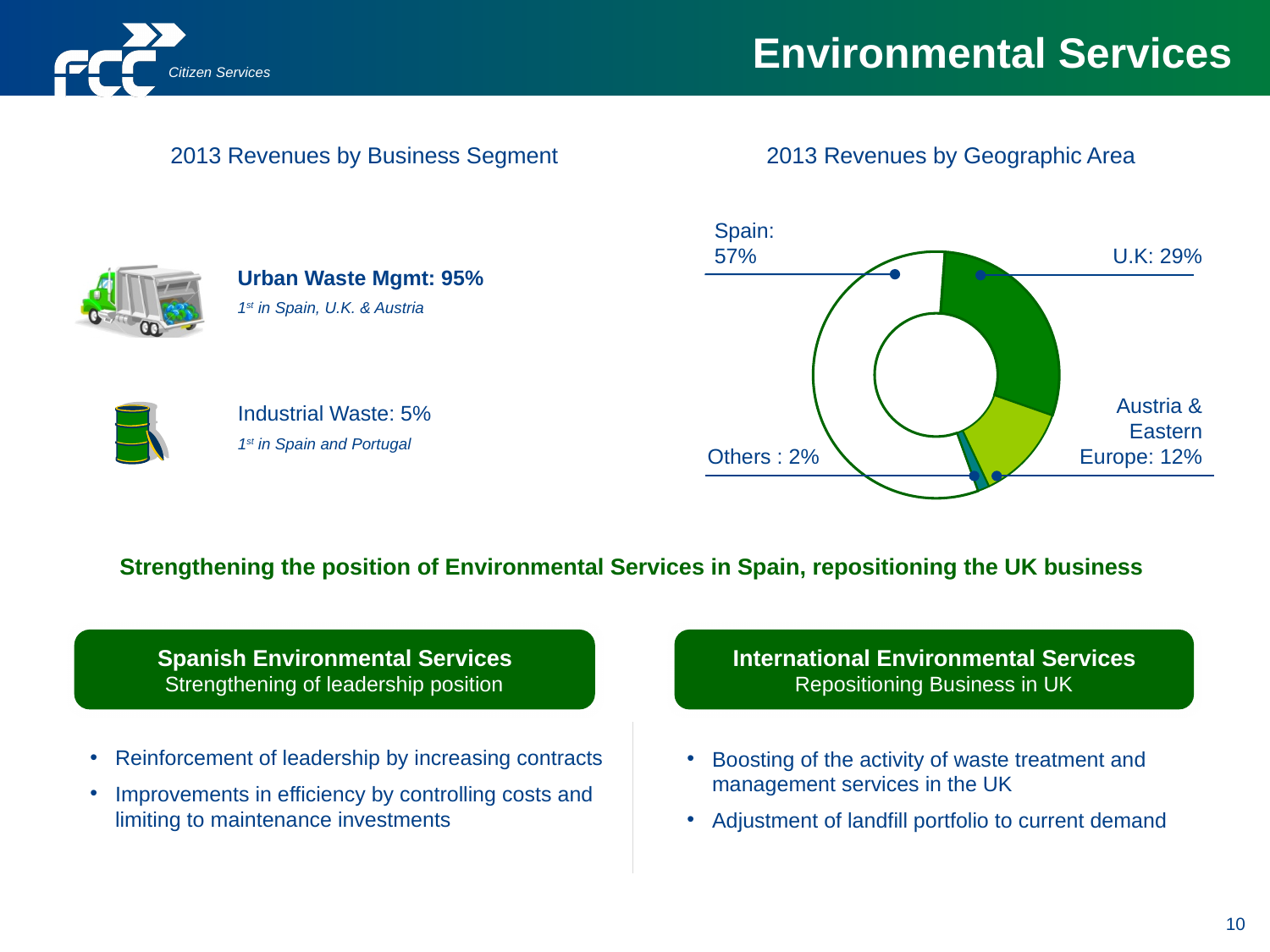
How many geographic areas are shown in the 2013 Revenues by Geographic Area chart? 4 In the 2013 Revenues by Geographic Area chart, what share of revenues comes from the U.K.? 29% In the 2013 Revenues by Geographic Area chart, what share of revenues comes from Others? 2% What kind of chart is used to show 2013 Revenues by Geographic Area? Doughnut (pie) chart In the 2013 Revenues by Geographic Area chart, which geographic area has the smallest share of revenues? Others In the 2013 Revenues by Geographic Area chart, how many percentage points larger is Spain's share than the U.K.'s share? 28 percentage points In the 2013 Revenues by Geographic Area chart, which geographic area has the largest share of revenues? Spain What is the title of the chart on the right side of the slide? 2013 Revenues by Geographic Area In the 2013 Revenues by Geographic Area chart, what share of revenues comes from Austria & Eastern Europe? 12% In the 2013 Revenues by Geographic Area chart, which has a larger share of revenues, the U.K. or Austria & Eastern Europe? U.K. In the 2013 Revenues by Geographic Area chart, what share of revenues comes from Spain? 57% In the 2013 Revenues by Geographic Area chart, what is the combined share of the U.K. and Austria & Eastern Europe? 41%